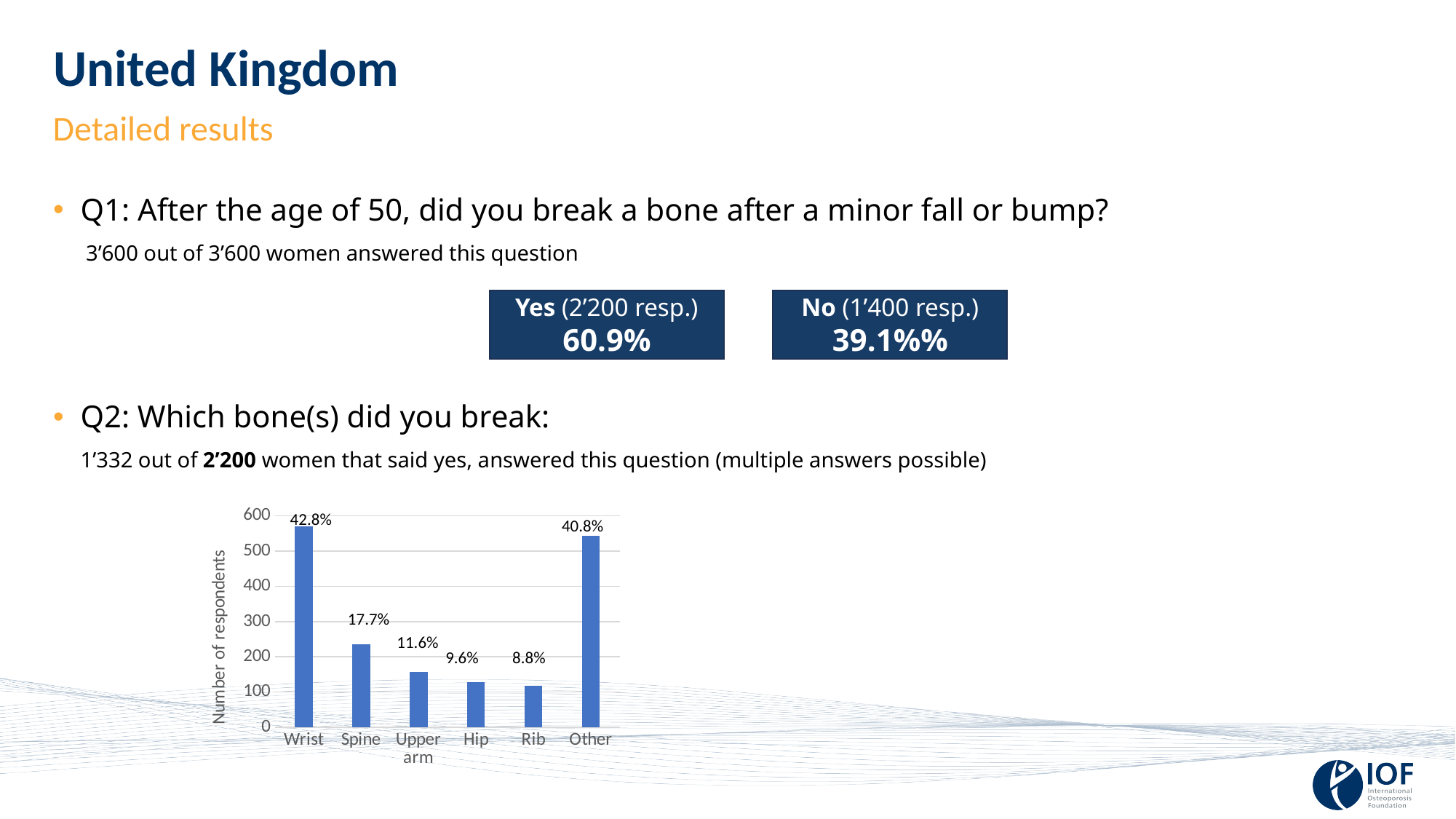
What percentage label is shown on the Spine bar? 17.7% Which has a higher value, Hip or Rib? Hip What percentage label is shown on the Wrist bar? 42.8% What is the difference in percentage points between the Wrist label and the Other label? 2.0% Is the number of respondents for Wrist greater or less than 500? greater Which bone category has the lowest bar? Rib What percentage label is shown on the Other bar? 40.8% Which bone category has the highest bar? Wrist How many bone categories are shown on the x axis of the chart? 6 What percentage label is shown on the Upper arm bar? 11.6% Is the number of respondents for Spine greater or less than 200? greater What kind of chart is used to show which bones were broken? Bar chart